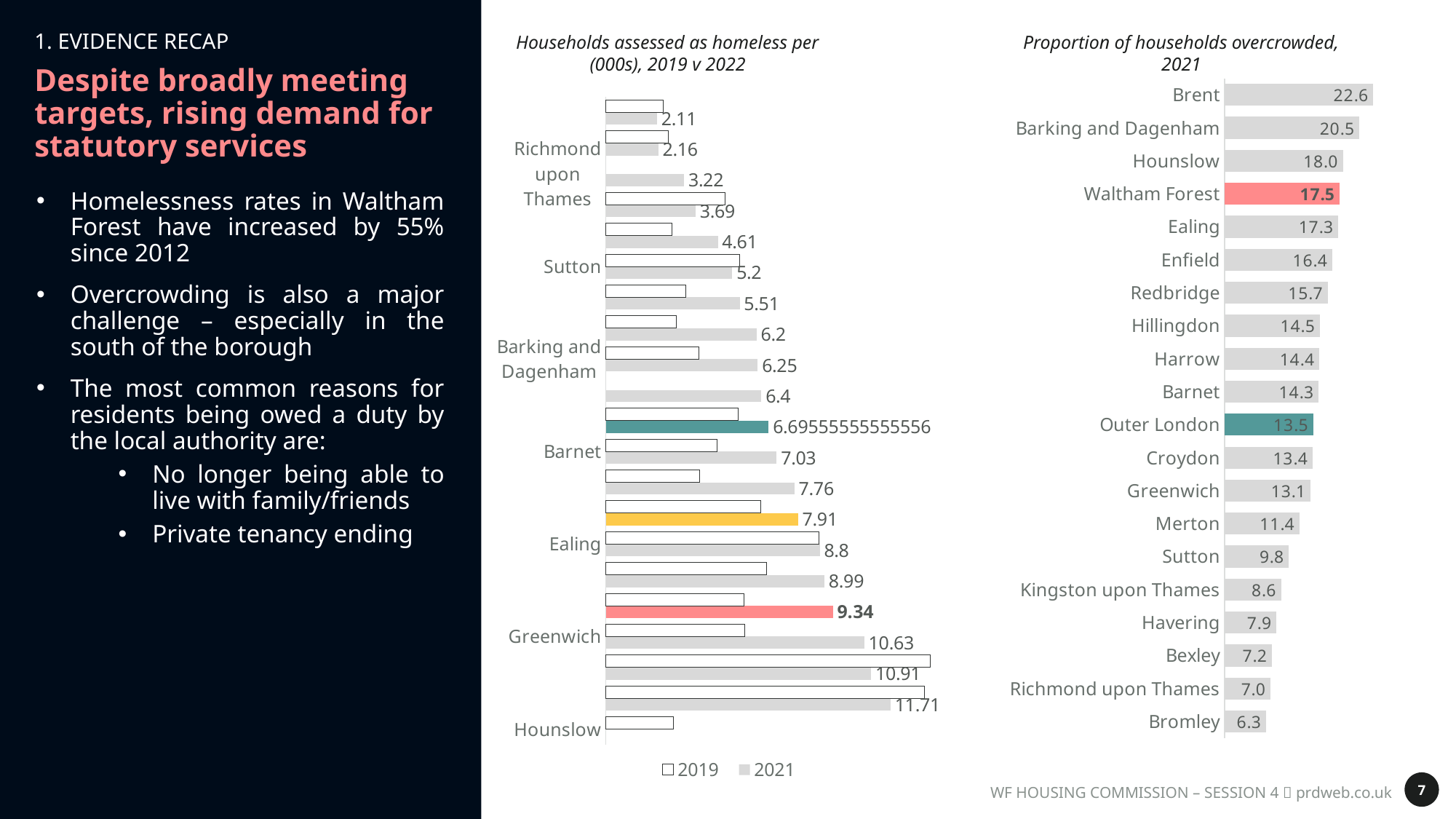
How many series does the legend list in the chart titled 'Households assessed as homeless per (000s), 2019 v 2022'? 2 In the chart titled 'Proportion of households overcrowded, 2021', what is the value for Waltham Forest? 17.5 In the chart titled 'Proportion of households overcrowded, 2021', which is larger, the value for Hounslow or the value for Ealing? Hounslow In the chart titled 'Proportion of households overcrowded, 2021', what is the value for Brent? 22.6 How many boroughs or areas are listed in the chart titled 'Proportion of households overcrowded, 2021'? 20 In the chart titled 'Proportion of households overcrowded, 2021', which borough has the highest value? Brent What are the two legend entries in the chart titled 'Households assessed as homeless per (000s), 2019 v 2022'? 2019 and 2021 What kind of chart is the chart titled 'Proportion of households overcrowded, 2021'? Bar chart In the chart titled 'Proportion of households overcrowded, 2021', what is the difference between the values for Waltham Forest and Outer London? 4.0 In the chart titled 'Households assessed as homeless per (000s), 2019 v 2022', what value is labelled on the pink highlighted bar? 9.34 In the chart titled 'Proportion of households overcrowded, 2021', what is the value for Outer London? 13.5 In the chart titled 'Proportion of households overcrowded, 2021', which borough has the lowest value? Bromley